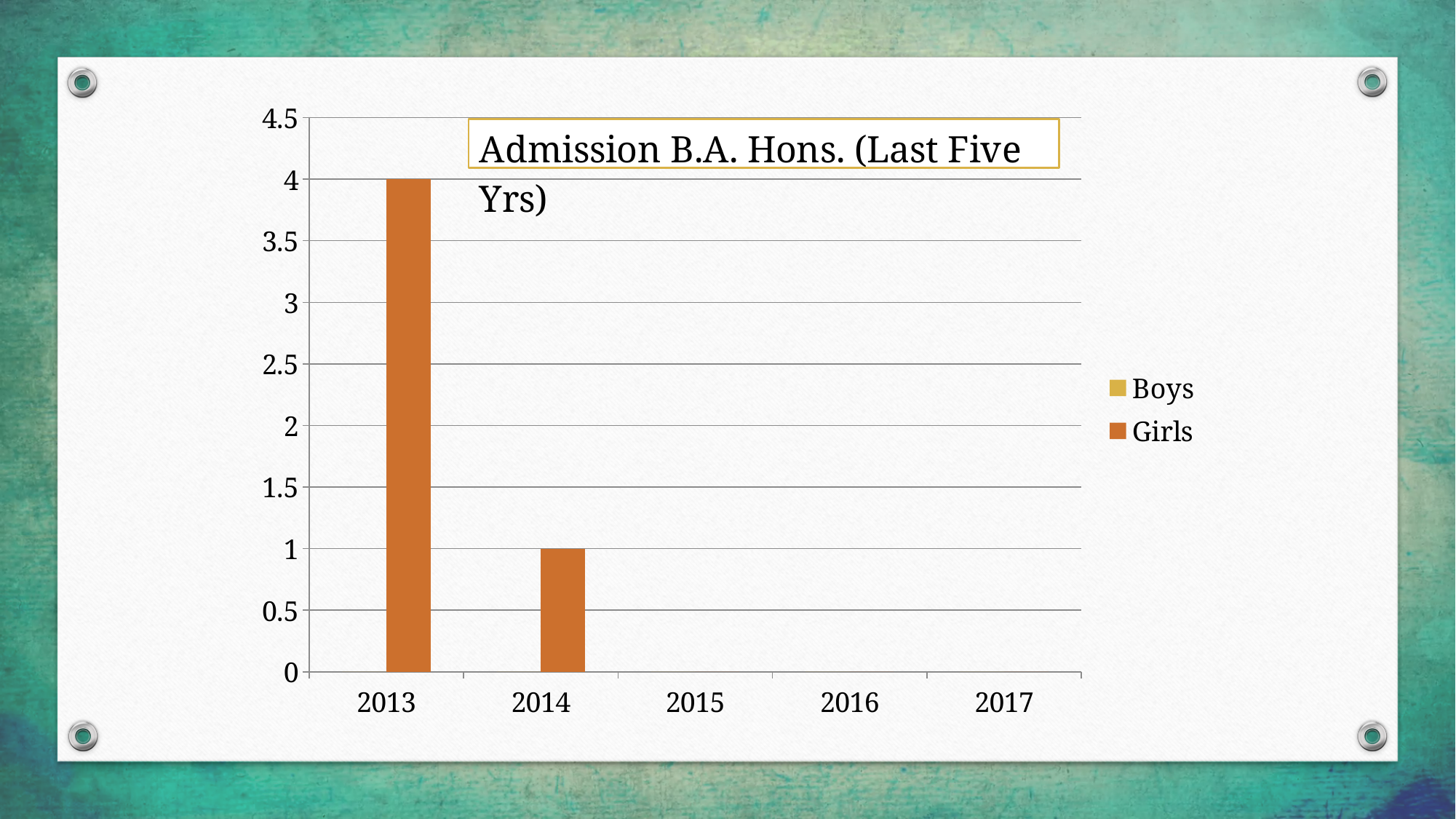
Do the Girls values rise or fall from 2013 to 2014? fall What is the value for Girls in 2014? 1 Which series are listed in the legend? Boys, Girls How many series does the legend list? 2 Which is larger, the Girls value for 2013 or for 2014? 2013 What kind of chart is shown on the slide? bar chart How many years are shown on the x axis? 5 Is the Girls value for 2013 greater or less than 3? greater In which year is the Girls value highest? 2013 What is the value for Girls in 2013? 4 What is the difference between the Girls values for 2013 and 2014? 3 What is the title of the chart? Admission B.A. Hons. (Last Five Yrs)